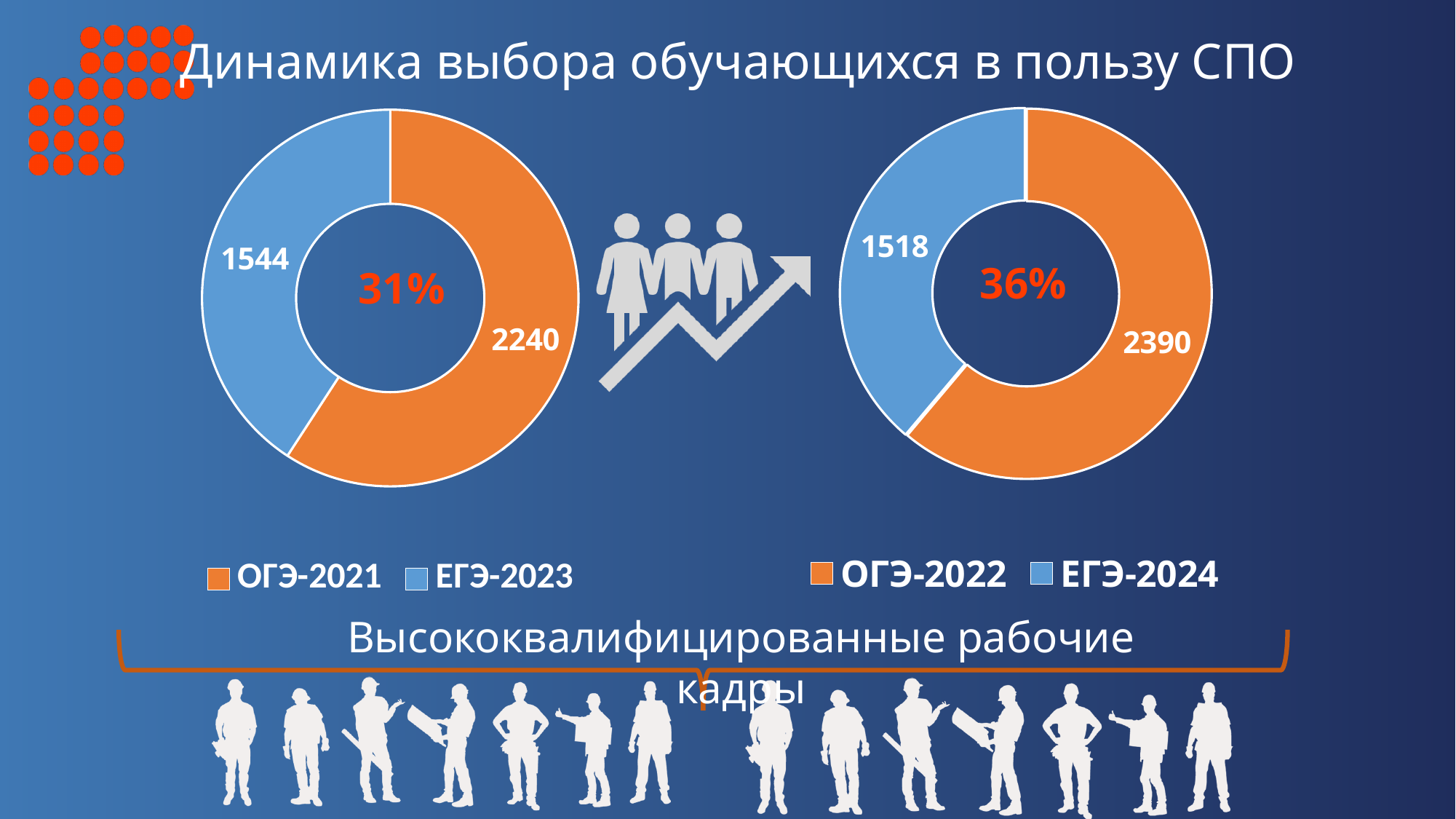
In the right doughnut chart, what is the difference between the values for ОГЭ-2022 and ЕГЭ-2024? 872 What percentage is printed in the centre of the right doughnut chart? 36% Is the value for ОГЭ-2022 in the right chart larger or smaller than the value for ОГЭ-2021 in the left chart? larger In the left doughnut chart, what is the value for ОГЭ-2021? 2240 In the right doughnut chart, which category has the smaller value? ЕГЭ-2024 How many entries does the legend of the right doughnut chart list? 2 What type of chart is used on the left side of the slide? Doughnut (pie) chart In the right doughnut chart, what is the value for ОГЭ-2022? 2390 In the left doughnut chart, which category has the larger value? ОГЭ-2021 In the left doughnut chart, what is the value for ЕГЭ-2023? 1544 In the left doughnut chart, what is the difference between the values for ОГЭ-2021 and ЕГЭ-2023? 696 In the right doughnut chart, what is the value for ЕГЭ-2024? 1518